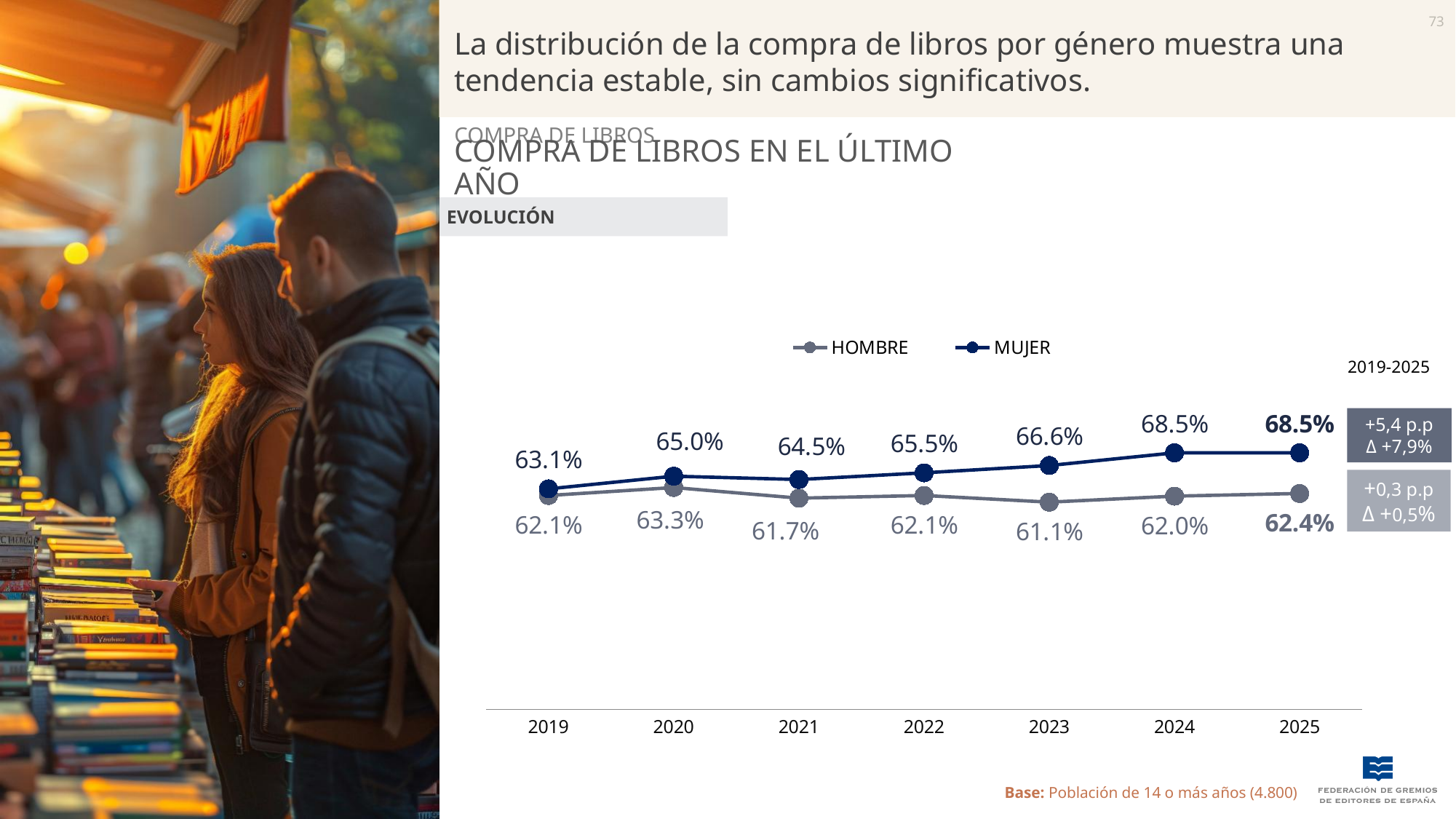
What is the difference between MUJER and HOMBRE in 2025? 6.1 percentage points How many years are shown on the x axis? 7 What is the value for MUJER in 2019? 63.1% Does the MUJER series generally rise or fall from 2019 to 2025? rise What is the value for HOMBRE in 2025? 62.4% What is the value for MUJER in 2023? 66.6% In which year is the HOMBRE series at its highest? 2020 What type of chart is shown on the slide? line chart What is the value for HOMBRE in 2021? 61.7% How many series does the legend list? 2 In which year is the HOMBRE series at its lowest? 2023 Which series has the higher value in 2022, HOMBRE or MUJER? MUJER